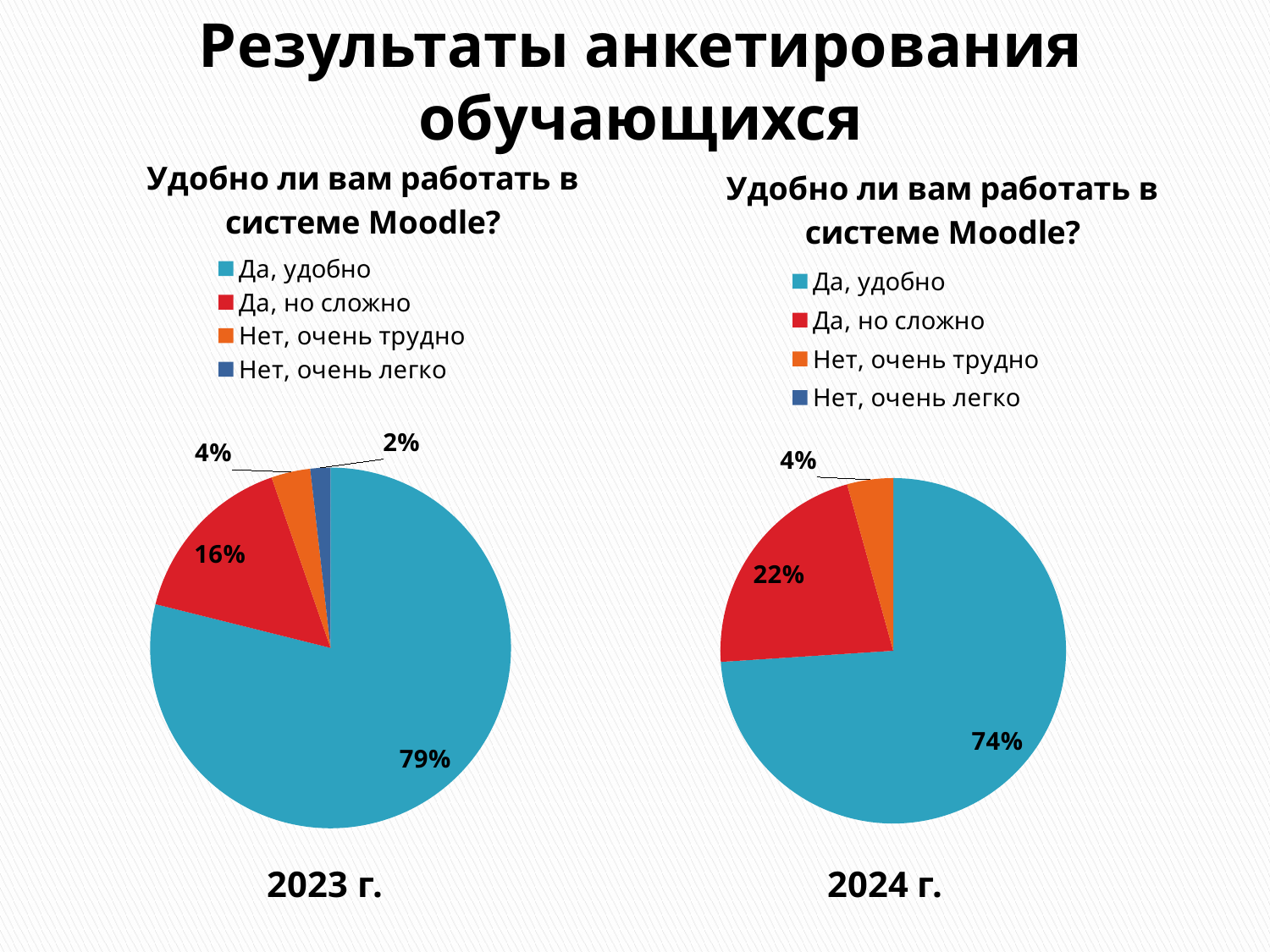
In the 2023 г. pie chart, which answer has the largest share? Да, удобно In the 2024 г. pie chart, what share of respondents answered "Да, удобно"? 74% How many entries does the legend of the 2024 г. chart list? 4 What type of chart is used on the left side of the slide for 2023 г.? Pie chart In the 2023 г. pie chart, which answer has the smallest share? Нет, очень легко In the 2023 г. pie chart, what percentage is shown for "Нет, очень легко"? 2% What is the difference between the "Да, но сложно" share in the 2024 г. chart and in the 2023 г. chart? 6% In the 2024 г. pie chart, what percentage is shown for "Да, но сложно"? 22% In the 2024 г. pie chart, what percentage is shown for "Нет, очень трудно"? 4% In the 2023 г. pie chart, what share of respondents answered "Да, удобно"? 79% In the 2023 г. pie chart, what percentage is shown for "Да, но сложно"? 16% Which chart shows a larger share for "Да, удобно": the 2023 г. chart or the 2024 г. chart? 2023 г.